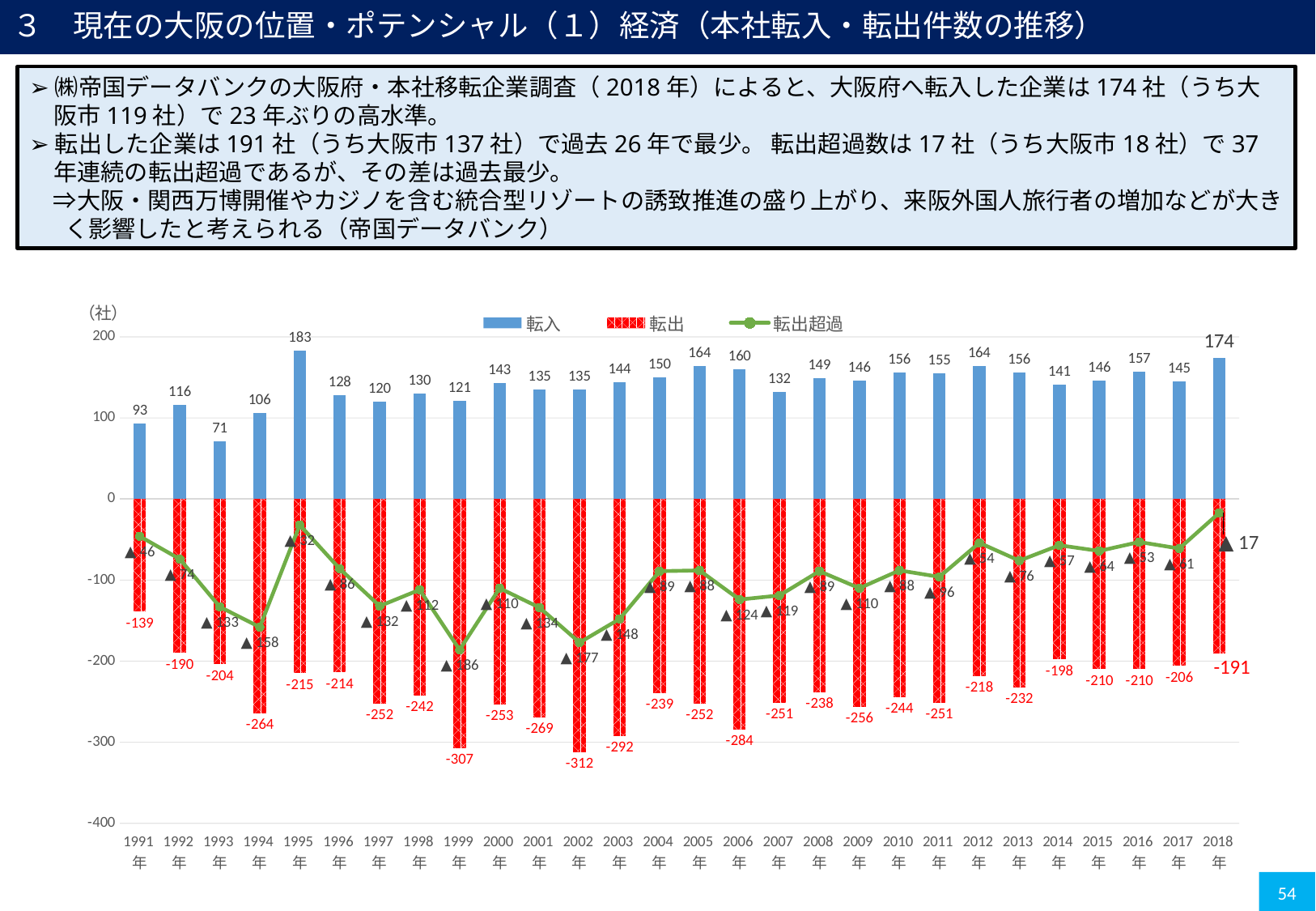
What is the value of 転出 for 2018年? -191 How many series does the legend list? 3 Which year has the larger 転入 value, 2005年 or 2006年? 2005年 What kind of chart is shown on the slide? Combined bar and line chart In which year does the 転出 bar reach its most negative value? 2002年 How many years are shown on the x axis? 28 What is the value of 転出 for 1999年? -307 What is the value of 転入 for 1995年? 183 What is the value of 転入 for 2018年? 174 What is the difference between the 転入 values for 2018年 and 1991年? 81 In which year is the 転入 value the highest? 1995年 In which year is the 転入 value the lowest? 1993年